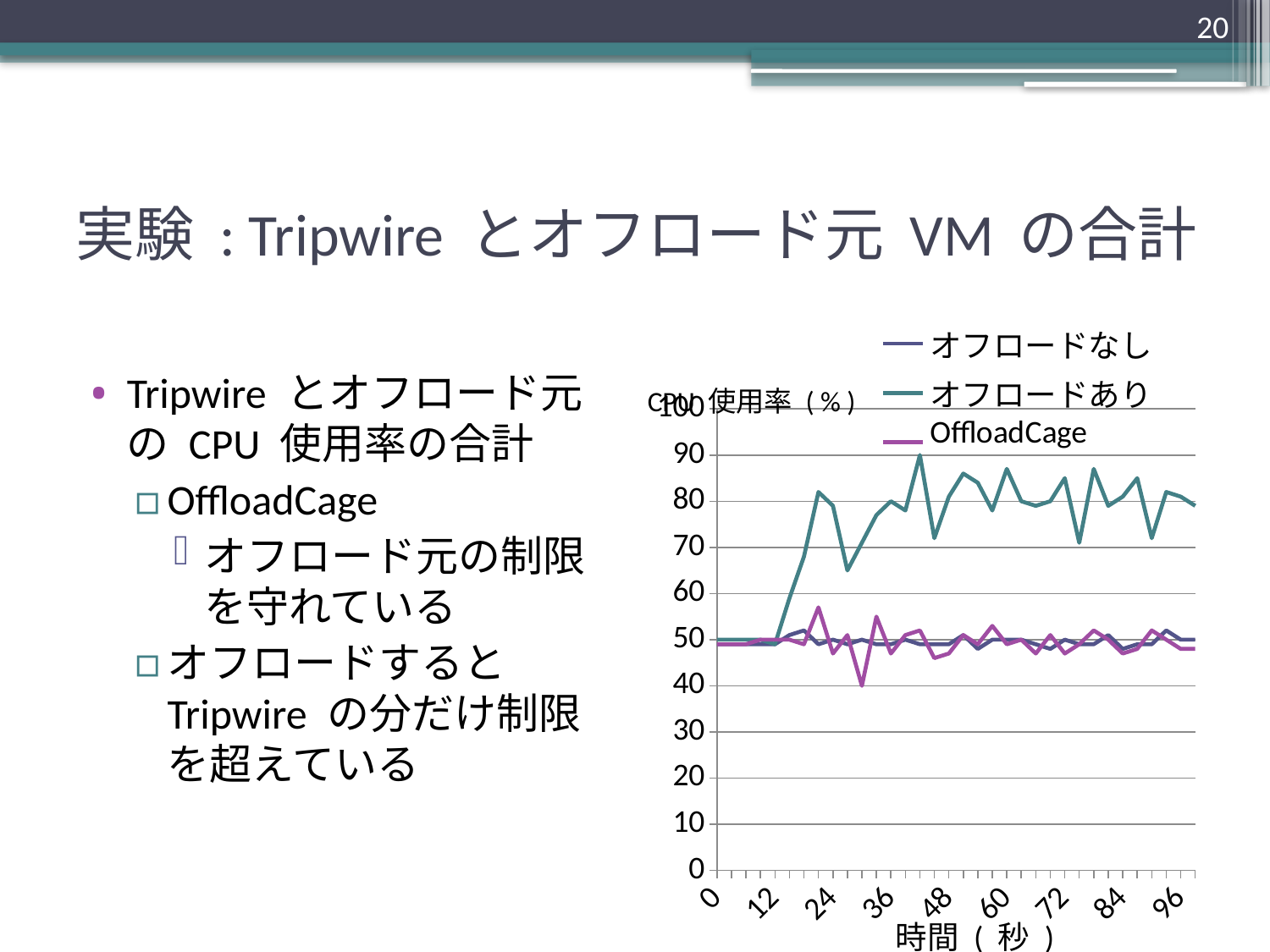
Does the オフロードあり series rise or fall between 12 and 24 seconds? rise Is the value for オフロードなし at 0 seconds greater or less than 60? less Is the value for オフロードあり at 36 seconds greater or less than 60? greater What kind of chart is shown on the slide? line chart Which series reaches the highest CPU usage in the chart? オフロードあり How many labelled tick marks are on the x axis? 9 Is the value for オフロードあり at 60 seconds greater or less than 70? greater What are the three series named in the chart's legend? オフロードなし, オフロードあり, OffloadCage What is the label of the chart's x axis? 時間（秒） How many series does the chart's legend list? 3 At 72 seconds, which series has the higher value, オフロードあり or OffloadCage? オフロードあり